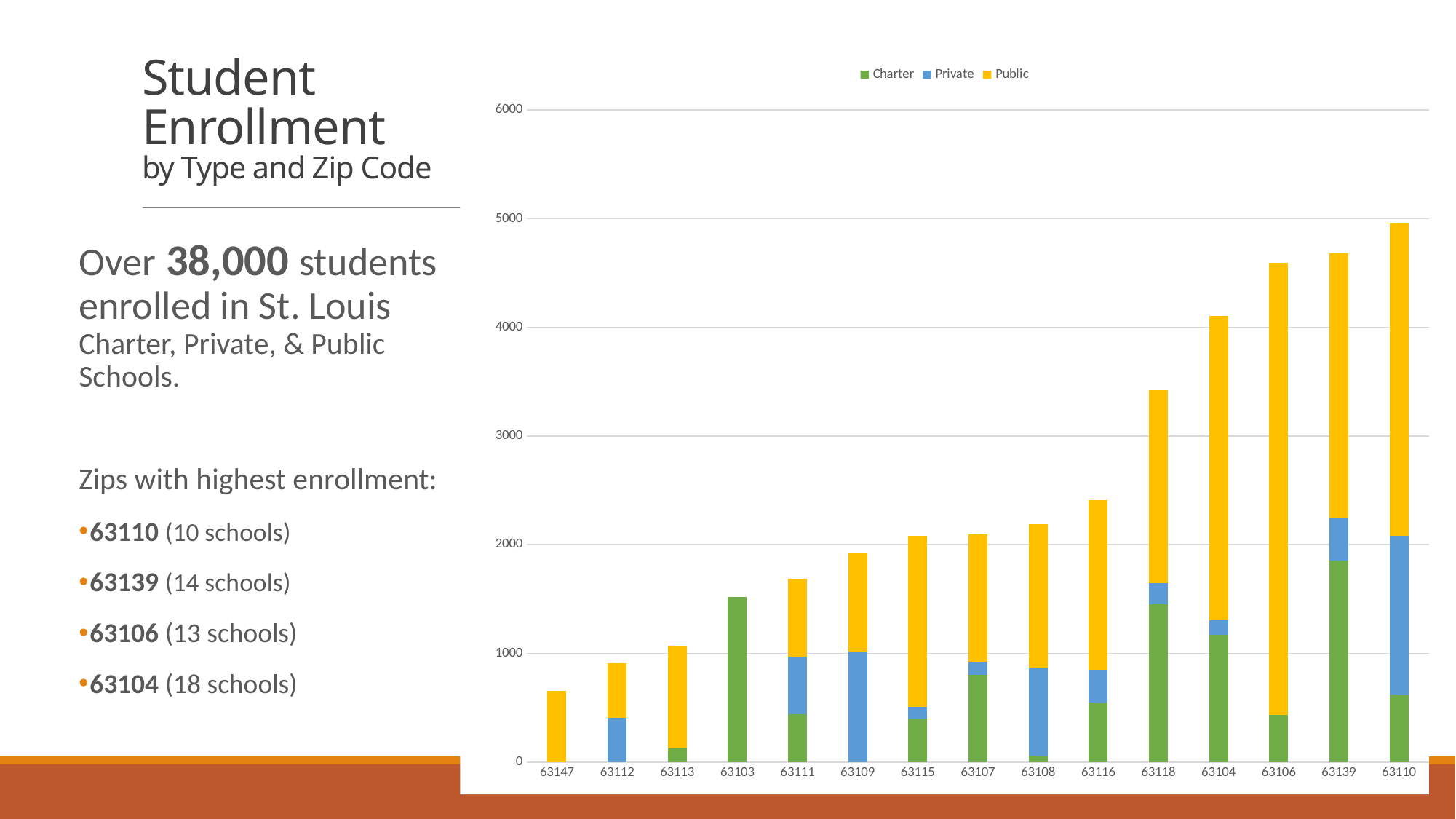
What kind of chart is shown on the slide? Stacked bar chart How many series does the chart's legend list? 3 Is the total enrollment for 63110 greater or less than 4000? greater Which zip code has the highest total enrollment in the chart? 63110 Which series in the legend is shown in yellow? Public How many zip codes are shown along the x axis of the chart? 15 Which has the larger total enrollment, 63118 or 63104? 63104 Is the total enrollment for 63118 greater or less than 3000? greater Is the total enrollment for 63147 greater or less than 1000? less Which zip code has the lowest total enrollment in the chart? 63147 Do the total bar heights rise or fall moving from left to right along the x axis? rise